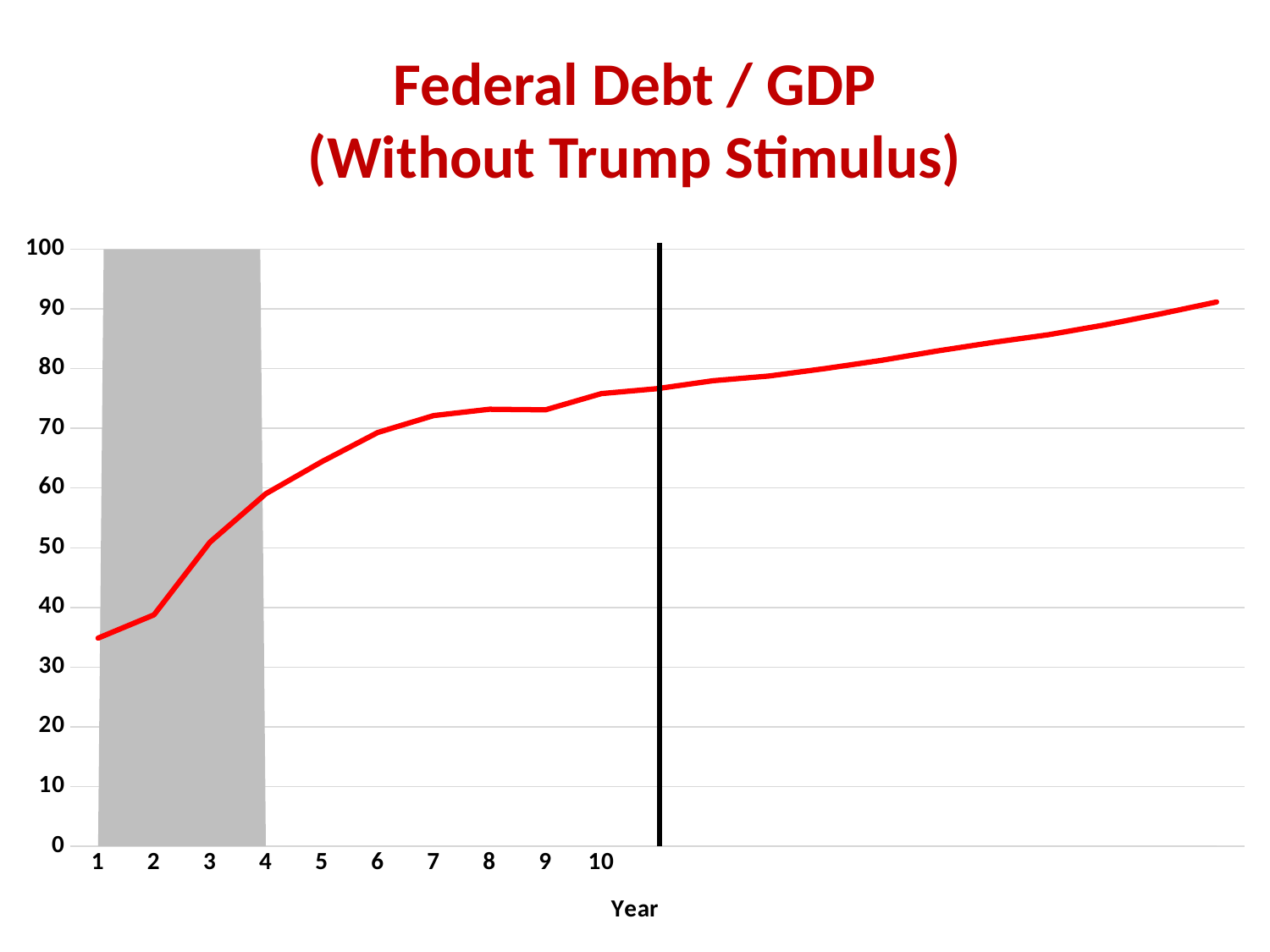
Which of the labeled years has the lowest value? Year 1 What is the label on the x axis? Year Is the value for Year 10 greater or less than 80? less Is the value for Year 10 greater or less than 70? greater Is the value for Year 1 greater or less than 40? less What kind of chart is shown on the slide? line chart Do the values rise or fall as the year increases along the x axis? rise What is the title of the chart? Federal Debt / GDP (Without Trump Stimulus) Which has the larger value, Year 1 or Year 10? Year 10